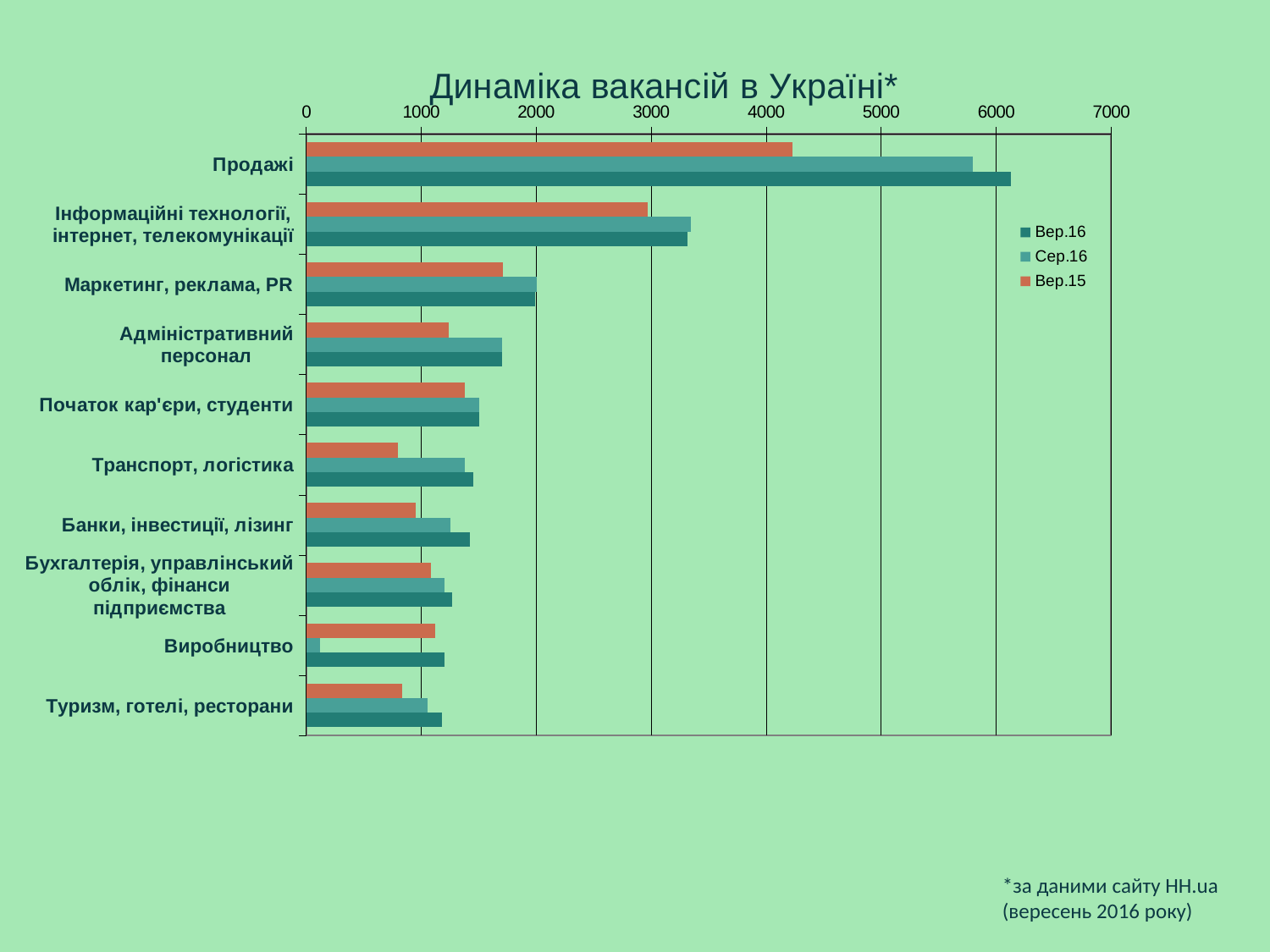
What is the title of the chart? Динаміка вакансій в Україні* How many categories (job sectors) are shown on the chart? 10 Is the Сер.16 value for Інформаційні технології, інтернет, телекомунікації greater or less than 3000? greater For Продажі, which is larger: the Вер.16 value or the Вер.15 value? Вер.16 Which category has the lowest value for Сер.16? Виробництво Is the Вер.16 value for Продажі greater or less than 6000? greater What kind of chart is shown on the slide? bar chart Is the Вер.15 value for Транспорт, логістика greater or less than 1000? less Which category has the highest value for Вер.16? Продажі For Транспорт, логістика, which is larger: the Сер.16 value or the Вер.15 value? Сер.16 How many series does the legend list? 3